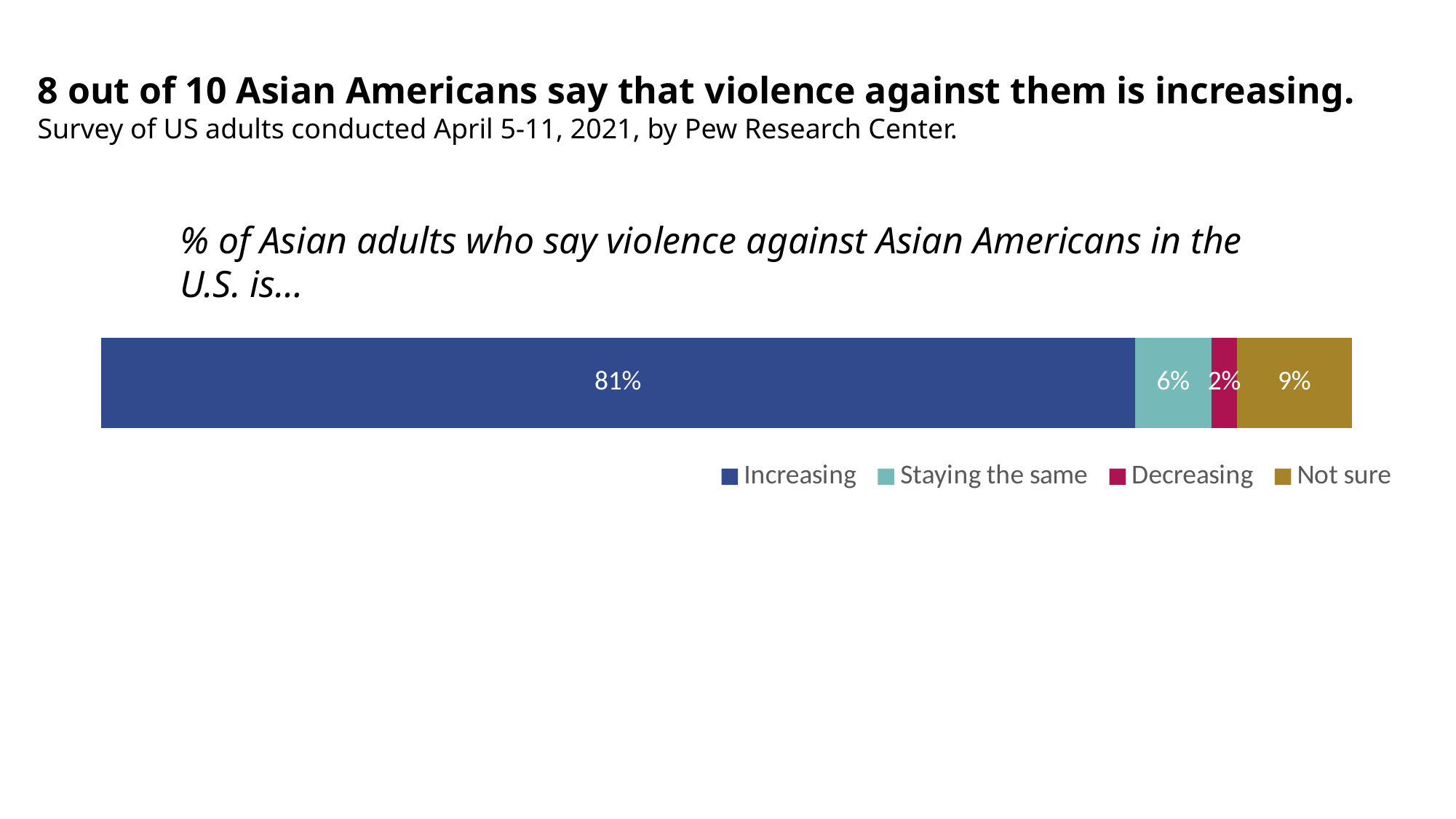
What percentage of Asian adults say violence against Asian Americans is decreasing? 2% What is the difference in percentage points between the 'Increasing' and 'Not sure' segments? 72 Which is larger, the 'Staying the same' segment or the 'Not sure' segment? Not sure Which response has the smallest share in the chart? Decreasing What percentage of Asian adults say violence against Asian Americans in the U.S. is increasing? 81% Which response has the largest share in the chart? Increasing What percentage of Asian adults say violence against Asian Americans is staying the same? 6% Which legend entry is shown in dark blue? Increasing What percentage of Asian adults say they are not sure? 9% What kind of chart is shown on the slide? Stacked bar chart What is the total of all segments in the stacked bar? 98% How many series does the legend list? 4